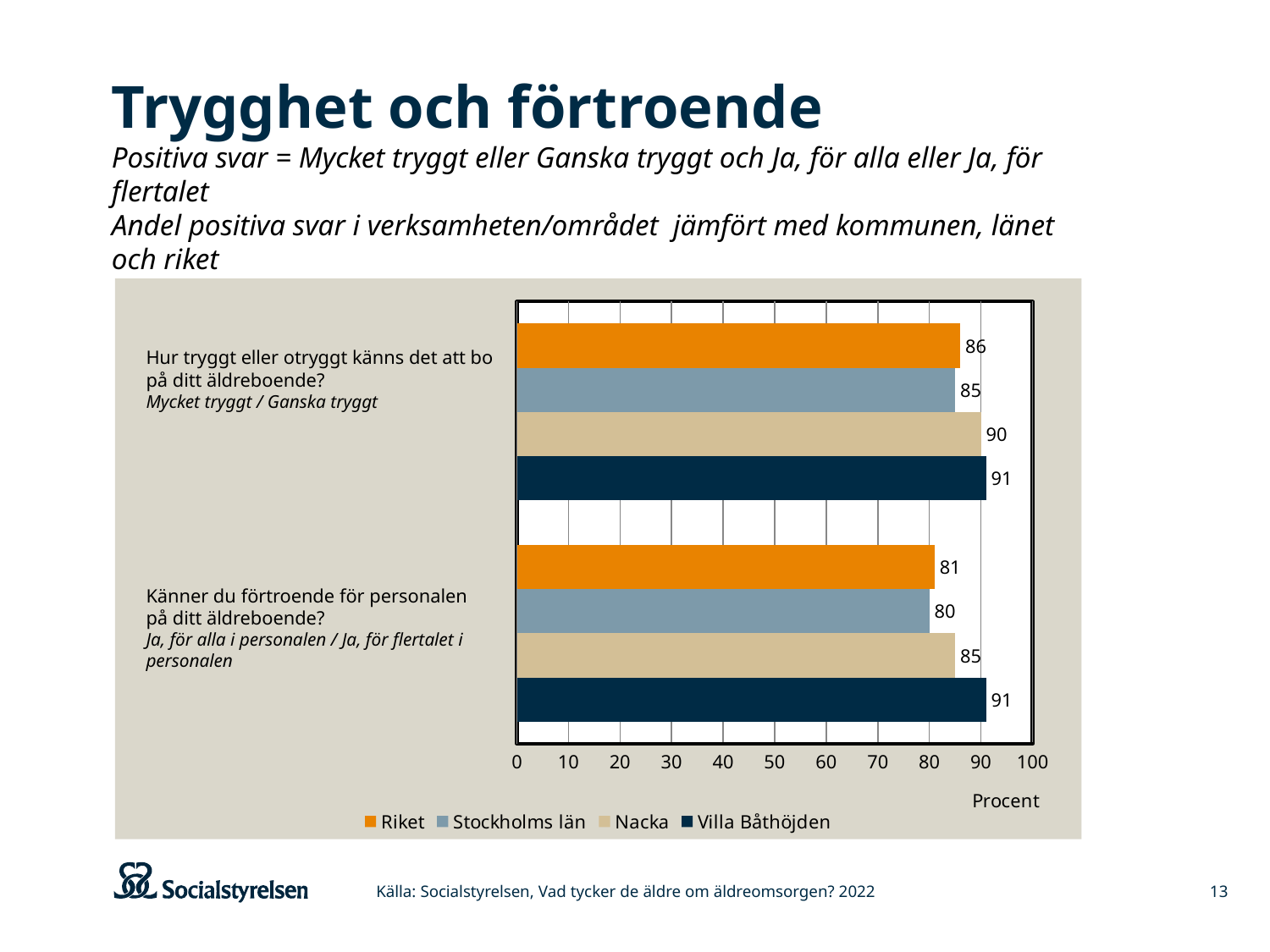
Which series has the lowest value on the question 'Känner du förtroende för personalen på ditt äldreboende?' Stockholms län How many series does the legend list? 4 What is the difference between Nacka and Stockholms län on the question 'Hur tryggt eller otryggt känns det att bo på ditt äldreboende?' 5 What is the difference between Villa Båthöjden and Riket on the question 'Känner du förtroende för personalen på ditt äldreboende?' 10 What is the value for Riket on the question 'Känner du förtroende för personalen på ditt äldreboende?' 81 What is the value for Nacka on the question 'Känner du förtroende för personalen på ditt äldreboende?' 85 Which series has the highest value on the question 'Hur tryggt eller otryggt känns det att bo på ditt äldreboende?' Villa Båthöjden Which is larger on the question 'Känner du förtroende för personalen på ditt äldreboende?': Nacka or Riket? Nacka What is the value for Stockholms län on the question 'Hur tryggt eller otryggt känns det att bo på ditt äldreboende?' 85 What kind of chart is shown on the slide? Bar chart What unit is shown on the x axis of the chart? Procent What is the value for Villa Båthöjden on the question 'Hur tryggt eller otryggt känns det att bo på ditt äldreboende?' 91